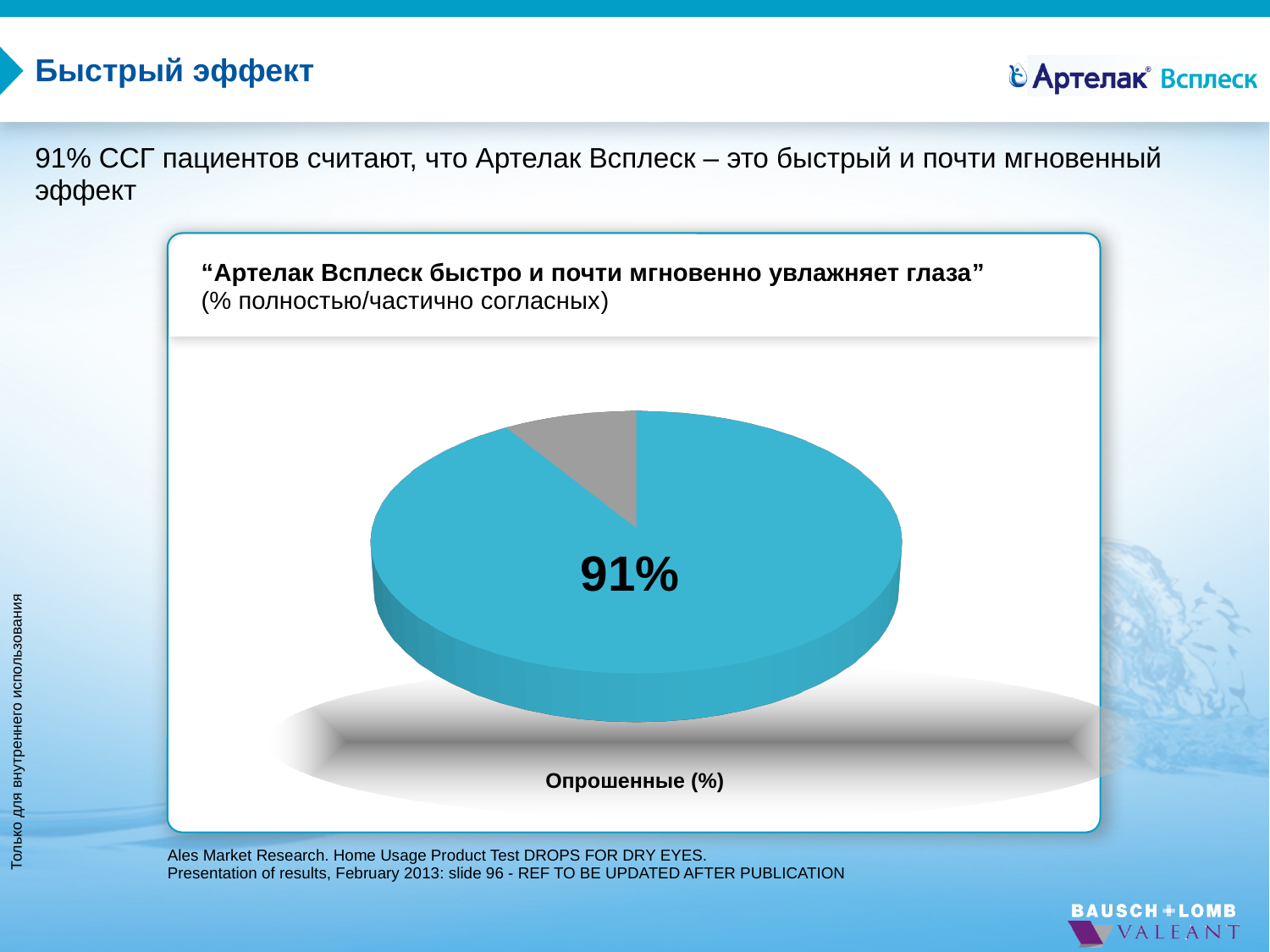
What is the label shown beneath the pie chart? Опрошенные (%) What percentage is printed on the large blue slice of the pie chart? 91% What share of the pie does the labelled slice represent? 91% Is the share of the blue slice in the pie chart greater or less than 50%? greater Which slice of the pie chart is larger, the blue one or the grey one? the blue one What colour is the slice labelled 91% in the pie chart? blue How many slices does the pie chart have? 2 What kind of chart is shown on the slide? pie chart